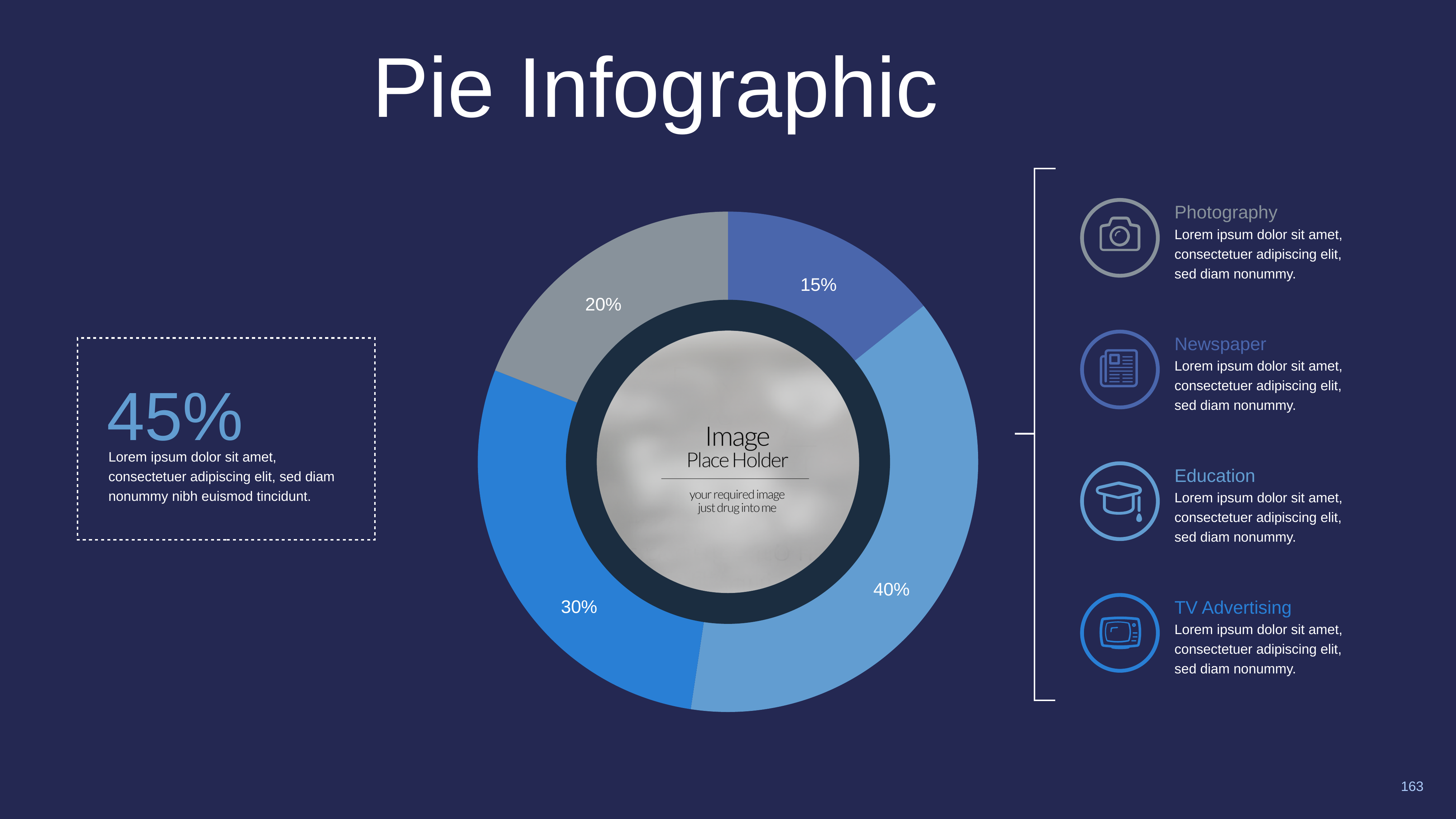
What is the largest value labelled on the pie chart? 40% What value is labelled on the dark indigo slice at the top right of the pie chart? 15% What is the difference between the largest and smallest slice values on the pie chart? 25% What value is labelled on the grey slice of the pie chart? 20% What is the smallest value labelled on the pie chart? 15% Which is larger on the pie chart: the light blue slice or the grey slice? The light blue slice What kind of chart is shown on the slide? Pie chart What is the title of the slide containing the pie chart? Pie Infographic What text is shown in the centre of the pie chart? Image Place Holder What value is labelled on the bright blue slice at the lower left of the pie chart? 30% What is the difference between the 30% slice and the 20% slice? 10% How many slices does the pie chart have? 4